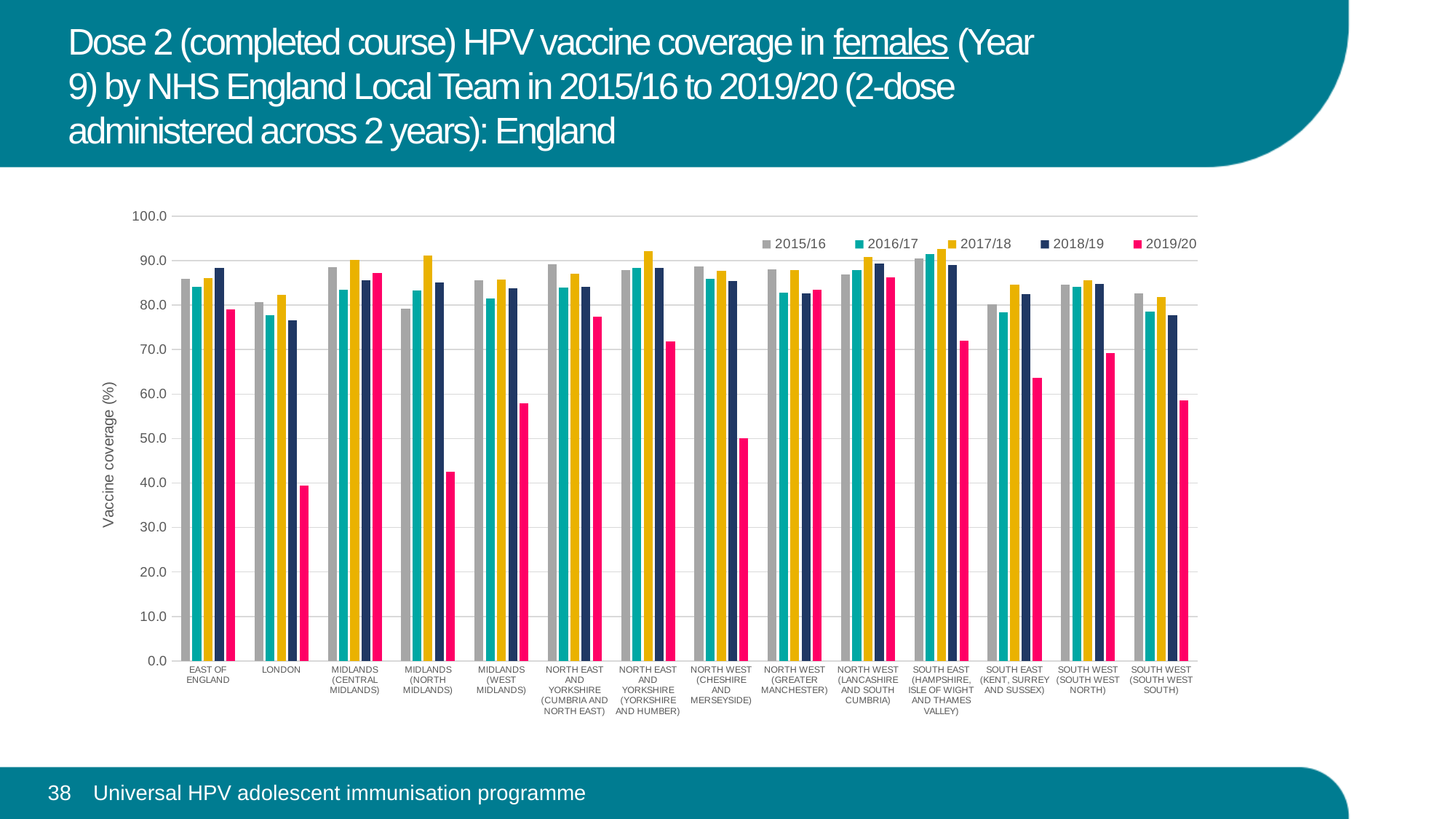
Which local team has the lowest 2019/20 value? London Which is larger: the 2019/20 value for London or the 2019/20 value for Midlands (Central Midlands)? Midlands (Central Midlands) Is the 2017/18 value for North East and Yorkshire (Yorkshire and Humber) greater or less than 90? greater Is the 2019/20 value for South West (South West South) greater or less than 70? less Is the 2019/20 value for Midlands (North Midlands) greater or less than 50? less How many series does the legend list? 5 What kind of chart is shown on the slide? Bar chart For North West (Cheshire and Merseyside), which is larger: the 2017/18 value or the 2019/20 value? 2017/18 How many NHS England Local Teams are shown on the x axis? 14 What is the label on the y axis? Vaccine coverage (%)